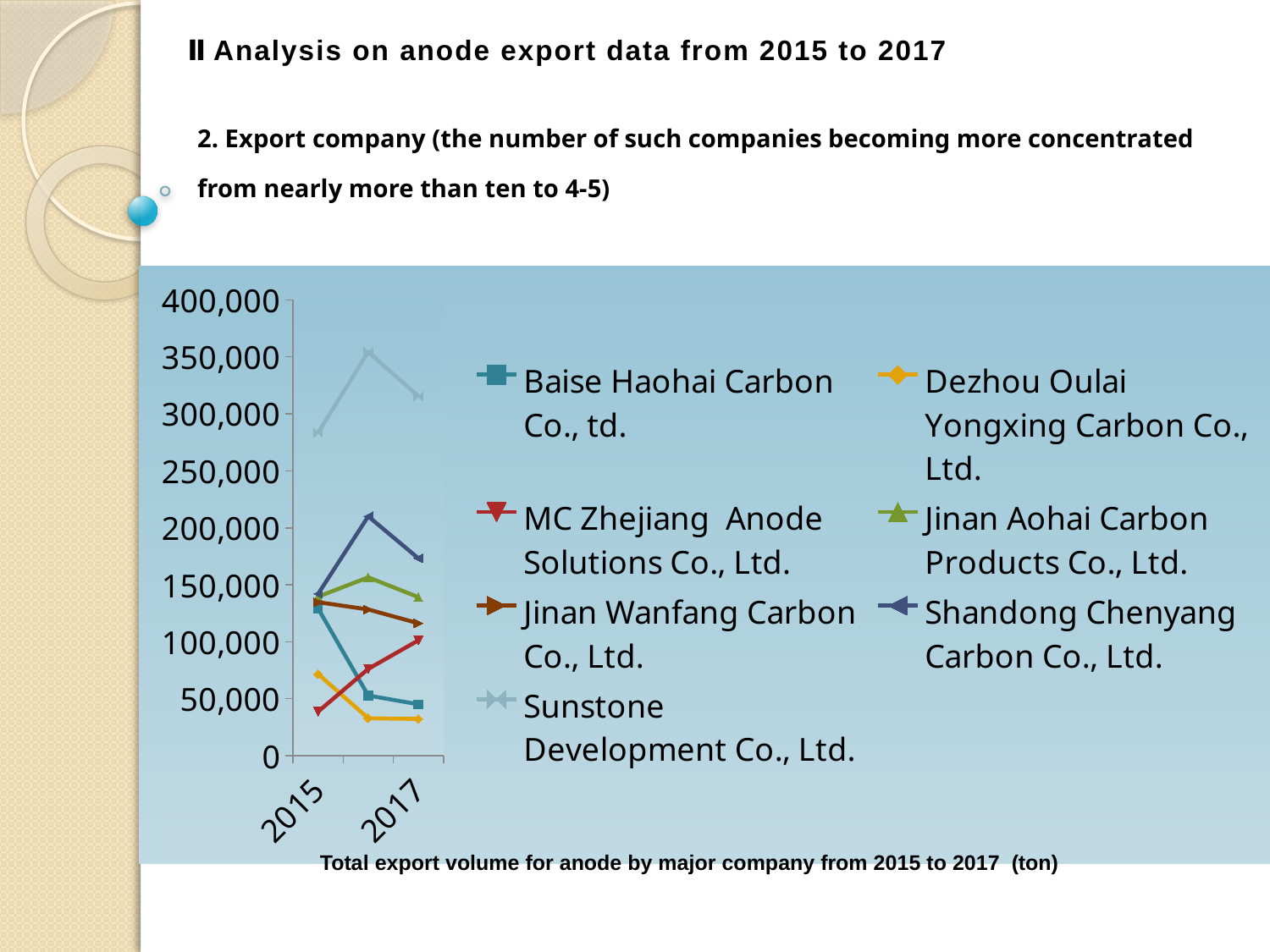
Does the export volume of MC Zhejiang Anode Solutions Co., Ltd. rise or fall from 2015 to 2017? rise Which company has the highest export volume in 2015? Sunstone Development Co., Ltd. Is the value for MC Zhejiang Anode Solutions Co., Ltd. in 2015 greater or less than 50,000? less Is the value for Baise Haohai Carbon Co., td. in 2015 greater or less than 100,000? greater In 2017, which is larger: the value for Shandong Chenyang Carbon Co., Ltd. or for Jinan Aohai Carbon Products Co., Ltd.? Shandong Chenyang Carbon Co., Ltd. Does the export volume of Baise Haohai Carbon Co., td. rise or fall from 2015 to 2017? fall Which company has the lowest export volume in 2015? MC Zhejiang Anode Solutions Co., Ltd. How many companies (series) does the legend list? 7 Is the value for Sunstone Development Co., Ltd. in 2015 greater or less than 250,000? greater What kind of chart is shown on the slide? line chart What is the caption/title given below the chart? Total export volume for anode by major company from 2015 to 2017 (ton) Which company has the lowest export volume in 2017? Dezhou Oulai Yongxing Carbon Co., Ltd.